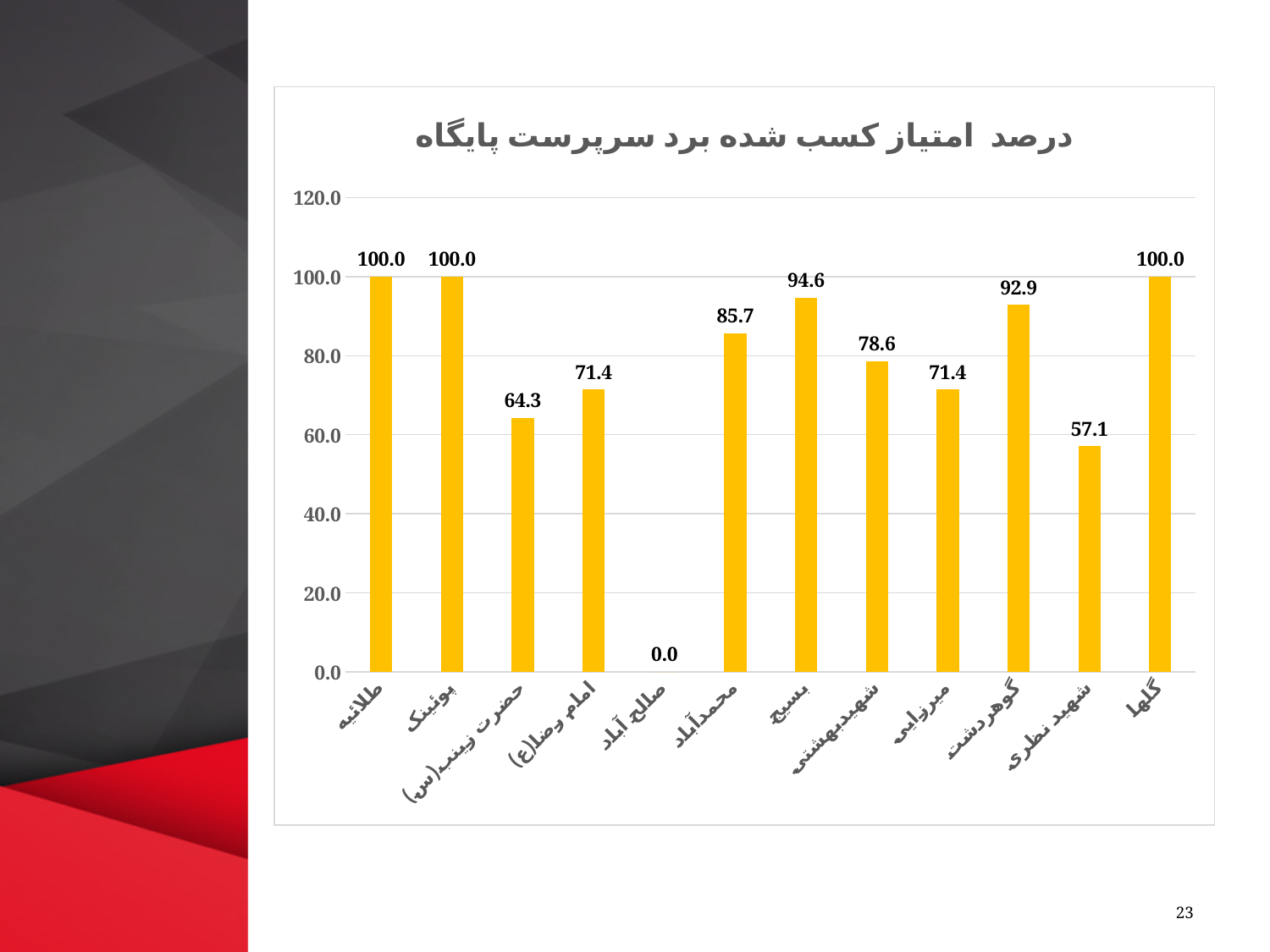
What is the value for بسیج? 94.6 What is the difference between the values for شهیدبهشتی and حضرت زینب(س)? 14.3 What is the difference between the values for بسیج and محمدآباد? 8.9 Is the value for شهید نظری greater or less than 60.0? less What kind of chart is shown on the slide? bar chart What is the value for صالح آباد? 0.0 What is the value for شهید نظری? 57.1 How many categories are shown on the x axis? 12 How many categories have a value of 100.0? 3 Which category has the lowest value? صالح آباد What is the value for گوهردشت? 92.9 Which is larger, the value for گوهردشت or the value for محمدآباد? گوهردشت